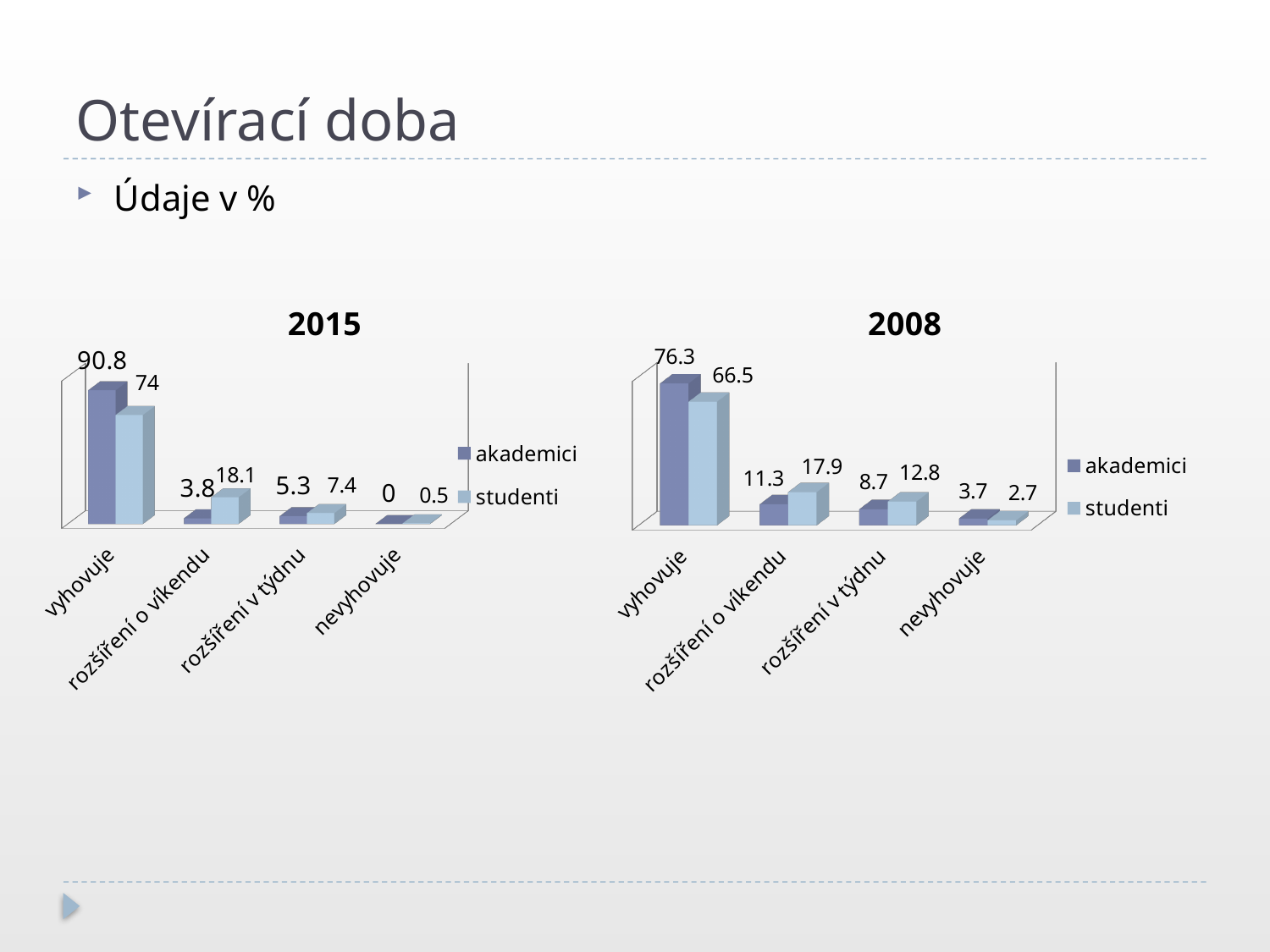
How many categories are shown on the x axis of the 2015 chart? 4 In the 2008 chart, which is larger for rozšíření v týdnu: akademici or studenti? studenti In the 2015 chart, what is the value for studenti in the rozšíření o víkendu category? 18.1 What kind of chart is the 2015 chart? bar chart How many series does the legend of the 2008 chart list? 2 In the 2008 chart, what is the value for studenti in the vyhovuje category? 66.5 In the 2015 chart, what is the value for akademici in the vyhovuje category? 90.8 In the 2008 chart, what is the difference between the akademici and studenti values for vyhovuje? 9.8 What are the two series named in the legend of the 2015 chart? akademici and studenti In the 2015 chart, which category has the highest value for studenti? vyhovuje In the 2008 chart, what is the value for akademici in the nevyhovuje category? 3.7 In the 2015 chart, which category has the lowest value for akademici? nevyhovuje